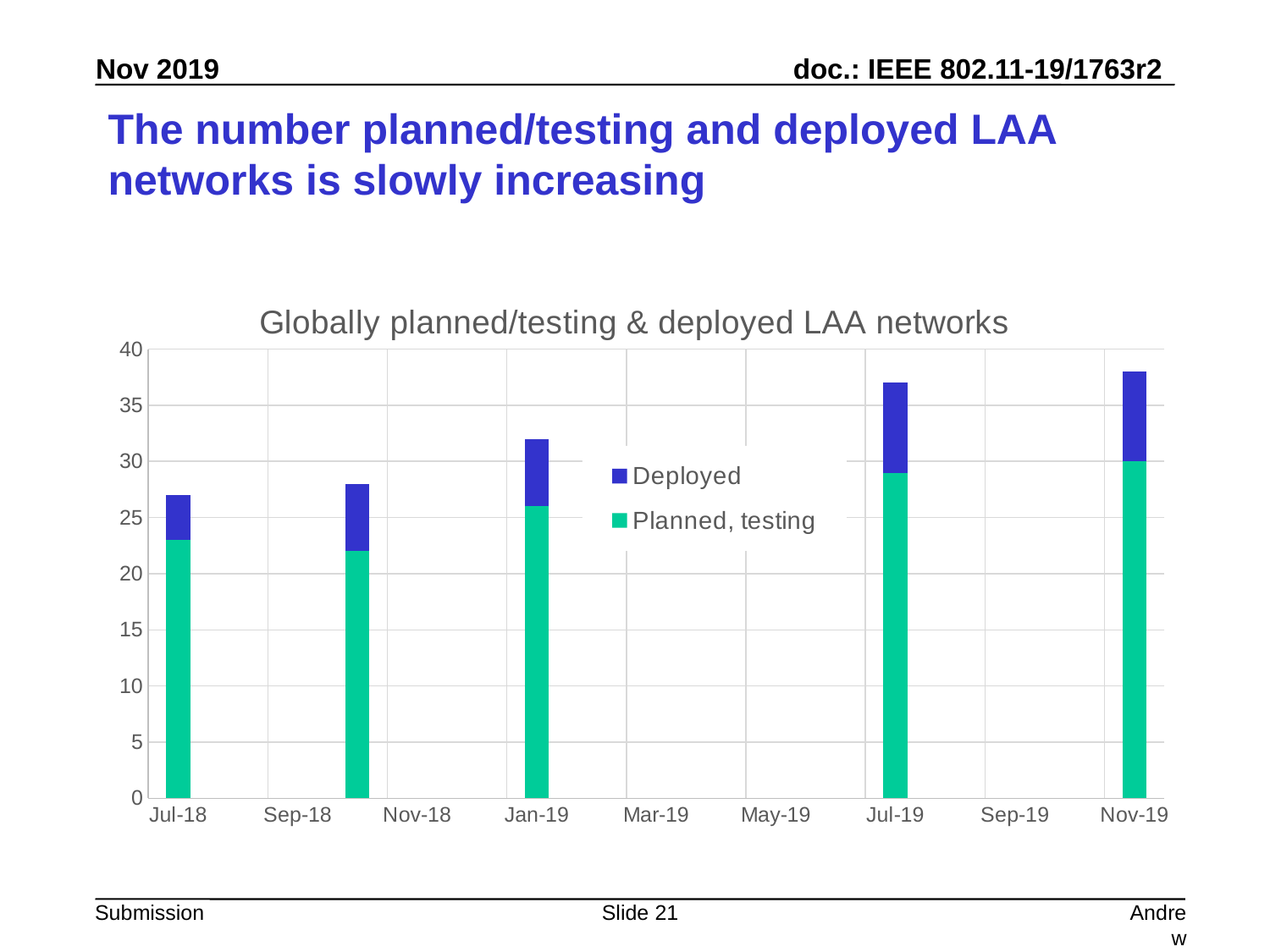
How many bars are plotted in the chart? 5 What kind of chart is shown on the slide? Stacked bar chart What are the two series named in the legend? Deployed; Planned, testing Do the total bar heights rise or fall from Jul-18 to Nov-19? Rise Which has the larger total, Jul-18 or Jan-19? Jan-19 Is the total value for Jan-19 greater or less than 35? less Is the total value for Nov-19 greater or less than 35? greater Is the Planned, testing value for Sep-18 greater or less than 25? less What is the title of the chart? Globally planned/testing & deployed LAA networks How many series does the legend list? 2